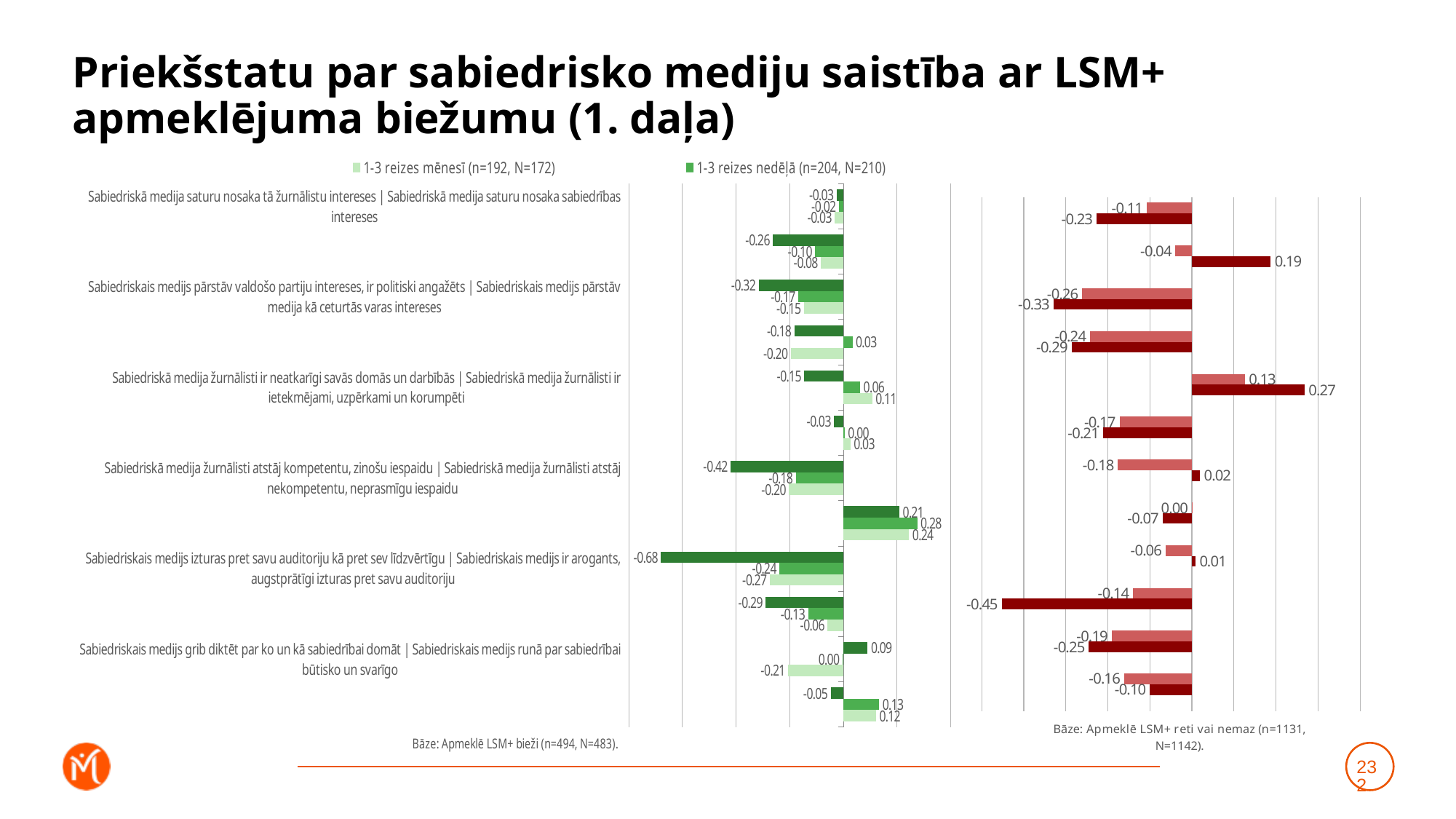
Which chart contains the lowest labelled value overall, the left (green) chart or the right (red) chart? the left (green) chart In the right (red) chart, what is the highest value labelled on any bar? 0.27 How many charts are shown on the slide? 2 What is the first legend entry shown above the charts? 1-3 reizes mēnesī (n=192, N=172) What is the difference between the lowest value in the left (green) chart (-0.68) and the lowest value in the right (red) chart (-0.45)? 0.23 In the left (green) chart, what is the lowest value labelled on any bar? -0.68 In the left (green) chart, what is the highest value labelled on any bar? 0.28 In the right (red) chart, what is the lowest value labelled on any bar? -0.45 What kind of chart is shown on the left side of the slide? bar chart What base (Bāze) text is shown under the right (red) chart? Bāze: Apmeklē LSM+ reti vai nemaz (n=1131, N=1142).